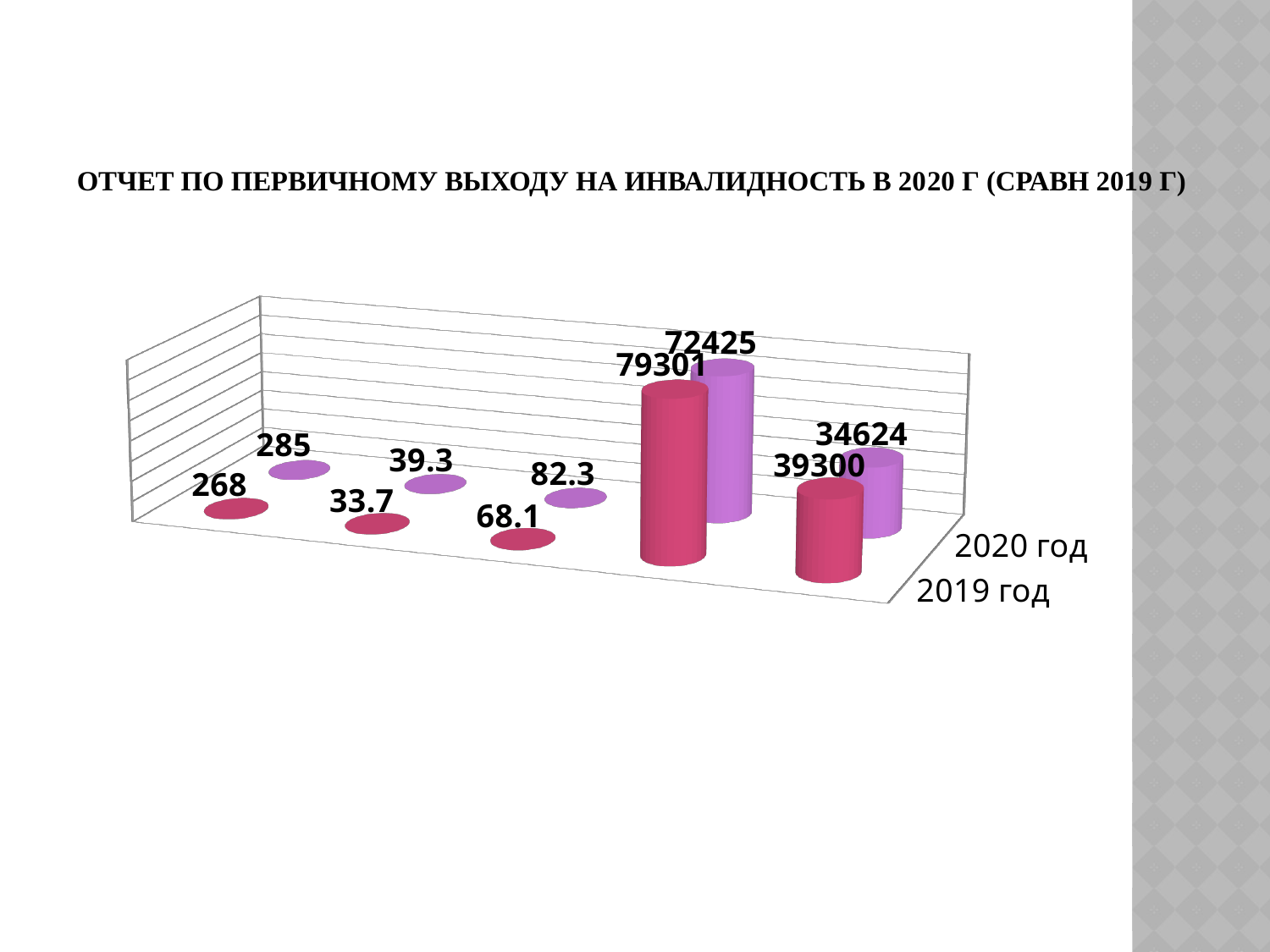
What is the value of the fifth bar in the 2020 год series? 34624 How many categories are plotted for each series? 5 What is the title of the chart? ОТЧЕТ ПО ПЕРВИЧНОМУ ВЫХОДУ НА ИНВАЛИДНОСТЬ В 2020 Г (СРАВН 2019 Г) Which bar has the lowest value in the 2019 год series? the second bar (33.7) Which bar has the highest value in the 2020 год series? the fourth bar (72425) What kind of chart is shown on the slide? bar chart What is the value of the fourth bar in the 2019 год series? 79301 What is the value of the first bar in the 2019 год series? 268 Which is larger: the fifth bar of 2019 год or the fifth bar of 2020 год? 2019 год (39300) What is the value of the first bar in the 2020 год series? 285 How many series does the chart show? 2 What is the difference between the fourth bar of 2019 год (79301) and the fourth bar of 2020 год (72425)? 6876